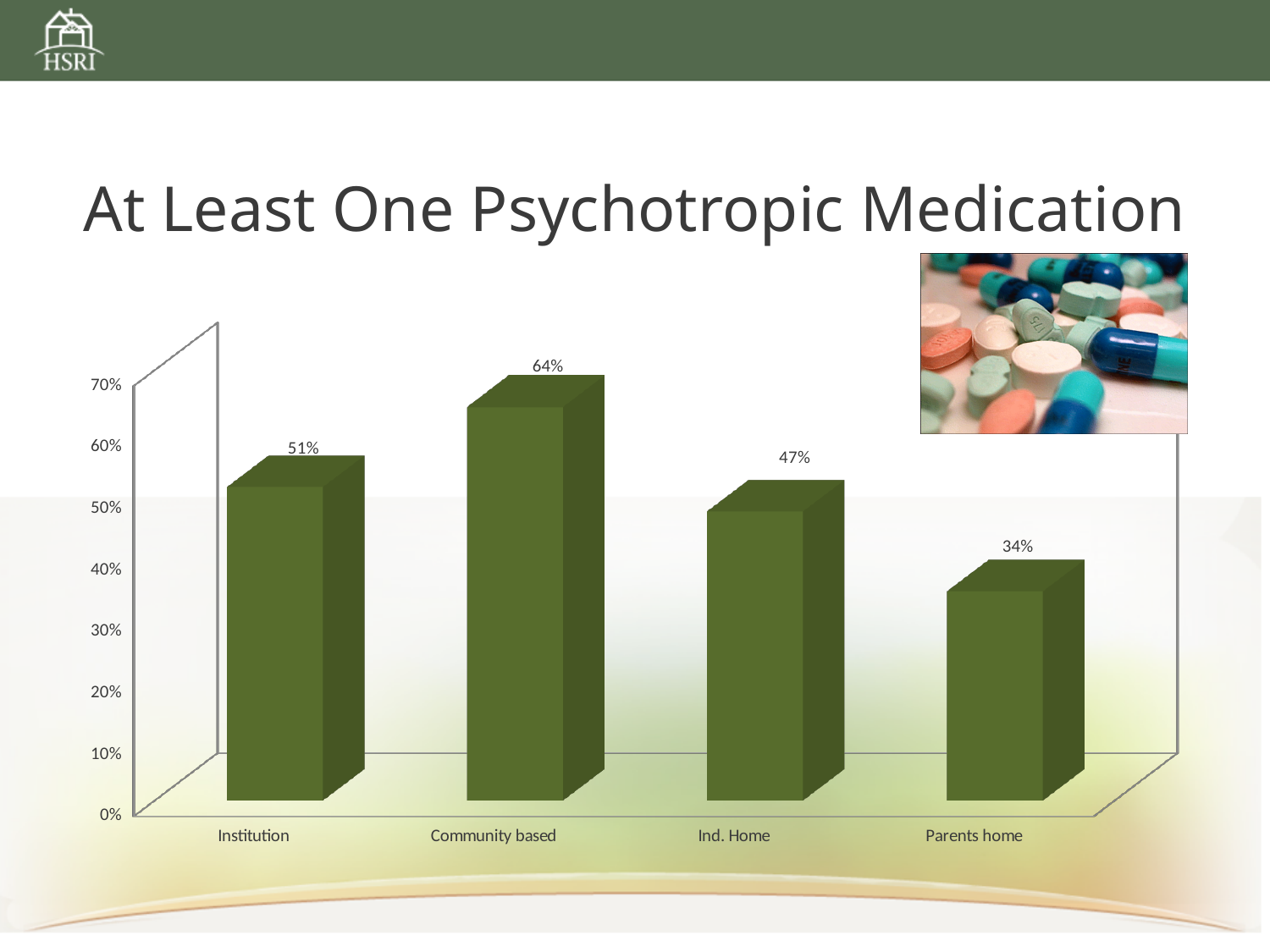
What is the difference between the values for Institution and Ind. Home? 4% What is the value for Community based? 64% How many categories are shown on the x axis? 4 What is the value for Institution? 51% What is the value for Ind. Home? 47% Which is larger, the value for Institution or the value for Parents home? Institution Which category has the lowest value? Parents home Is the value for Ind. Home greater or less than 50%? less What is the difference between the values for Community based and Parents home? 30% What kind of chart is shown on the slide? bar chart Which category has the highest value? Community based What is the value for Parents home? 34%